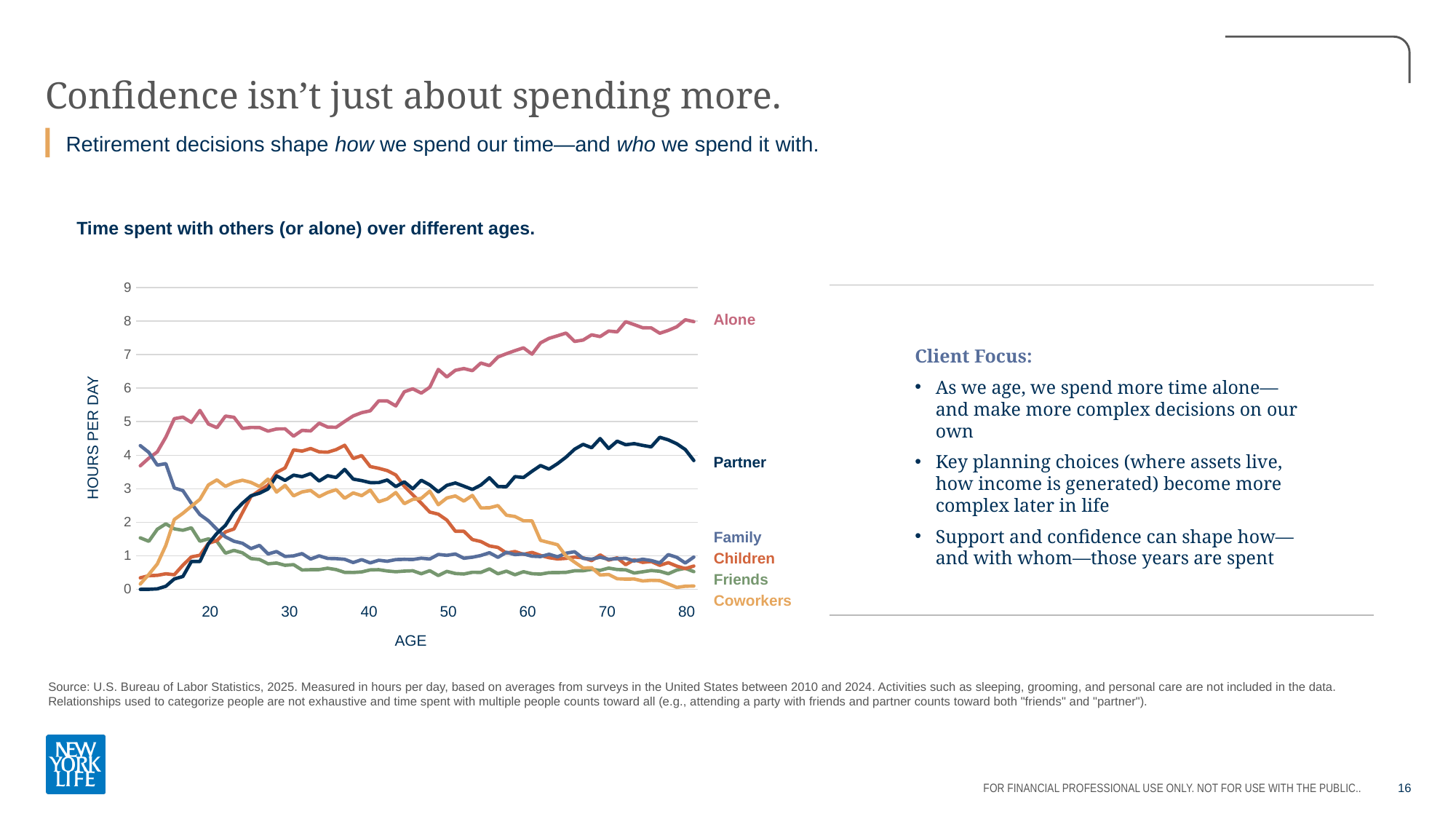
Does the Coworkers series rise or fall between age 60 and age 80? Fall At age 40, which is larger: the value for Children or the value for Family? Children Is the value for Children at age 80 greater or less than 1? less What is the label on the vertical axis of the chart? HOURS PER DAY What kind of chart is shown on the slide? Line chart Which series has the highest value at age 80? Alone At age 20, which is larger: the value for Alone or the value for Partner? Alone Which series has the lowest value at age 80? Coworkers Is the value for Partner at age 70 greater or less than 3? greater How many series are plotted on the chart? 6 Does the Alone series generally rise or fall as age increases? Rise Is the value for Alone at age 80 greater or less than 7? greater